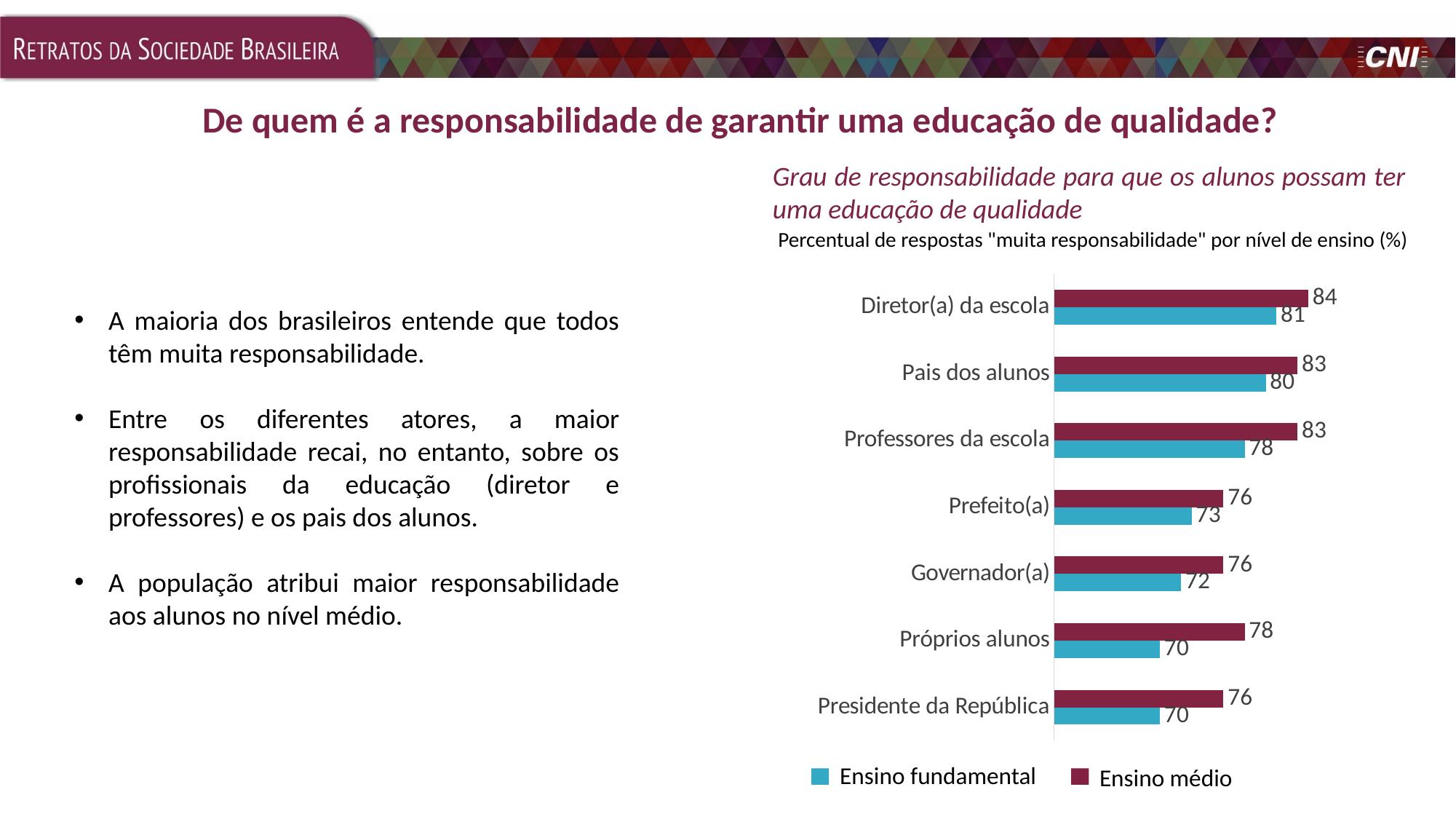
Which is larger: the Ensino fundamental value for Pais dos alunos or for Governador(a)? Pais dos alunos What is the value for Ensino médio for Governador(a)? 76 How many series does the legend list? 2 What is the value for Ensino fundamental for Próprios alunos? 70 Which category has the highest value for Ensino médio? Diretor(a) da escola What is the difference between Ensino médio and Ensino fundamental for Próprios alunos? 8 How many categories are shown in the chart? 7 What is the value for Ensino fundamental for Prefeito(a)? 73 What is the difference between Ensino médio and Ensino fundamental for Professores da escola? 5 What is the value for Ensino médio for Diretor(a) da escola? 84 Which category has the lowest value for Ensino fundamental? Próprios alunos and Presidente da República (both 70) What kind of chart is shown on the slide? Bar chart